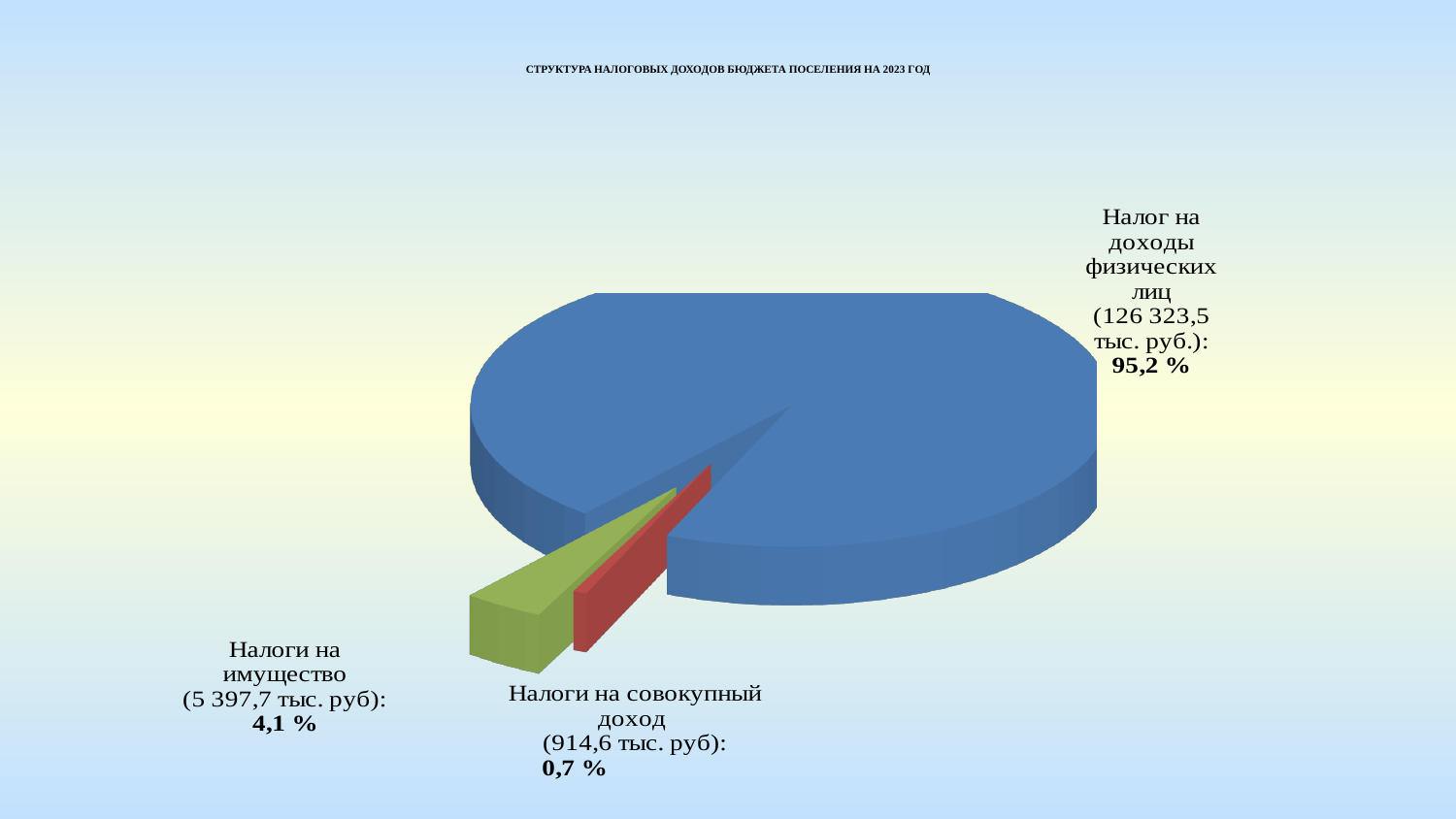
What is the title of the chart? СТРУКТУРА НАЛОГОВЫХ ДОХОДОВ БЮДЖЕТА ПОСЕЛЕНИЯ НА 2023 ГОД Which category has the smallest slice of the pie? Налоги на совокупный доход What amount in тыс. руб. is shown for Налоги на имущество? 5 397,7 тыс. руб What share of the pie is Налог на доходы физических лиц? 95,2 % How many slices does the pie chart have? 3 What share of the pie is Налоги на совокупный доход? 0,7 % What kind of chart is shown on the slide? Pie chart What amount in тыс. руб. is shown for Налог на доходы физических лиц? 126 323,5 тыс. руб. What amount in тыс. руб. is shown for Налоги на совокупный доход? 914,6 тыс. руб Which category has the largest slice of the pie? Налог на доходы физических лиц What is the difference in percentage points between the shares of Налоги на имущество and Налоги на совокупный доход? 3,4 % What share of the pie is Налоги на имущество? 4,1 %